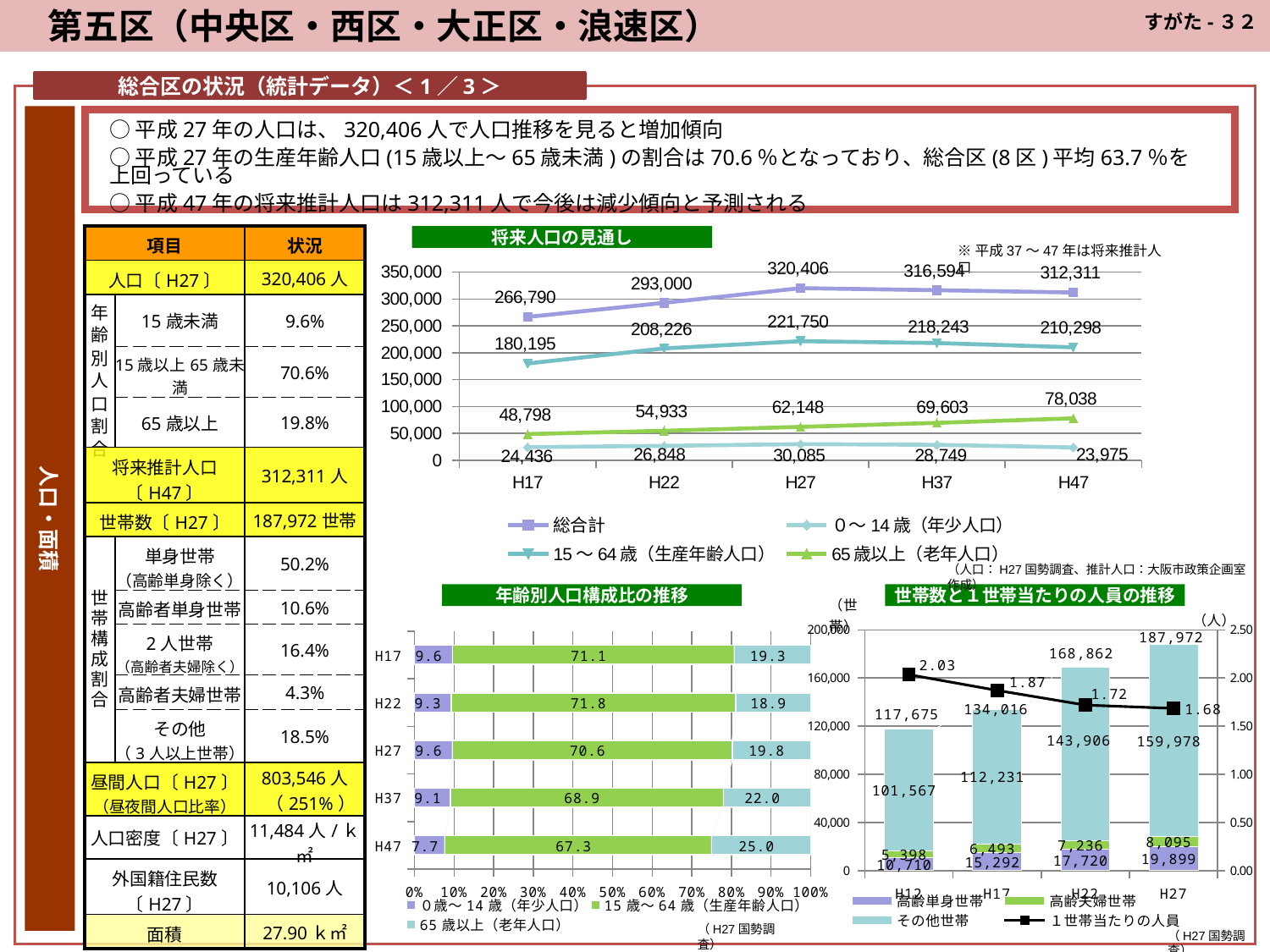
In the 将来人口の見通し chart, does the 65歳以上（老年人口） series rise or fall from H17 to H47? rise In the 年齢別人口構成比の推移 chart, which year has the lowest value for 0歳～14歳（年少人口）? H47 In the 世帯数と１世帯当たりの人員の推移 chart, what is the value for 高齢単身世帯 in H27? 19,899 What kind of chart is 年齢別人口構成比の推移? bar chart In the 将来人口の見通し chart, what is the value for 65歳以上（老年人口） in H47? 78,038 In the 将来人口の見通し chart, what is the difference between the 総合計 values for H27 and H47? 8,095 How many series does the legend of the 将来人口の見通し chart list? 4 In the 世帯数と１世帯当たりの人員の推移 chart, how many years are shown on the x axis? 4 In the 将来人口の見通し chart, what is the 総合計 value for H27? 320,406 In the 世帯数と１世帯当たりの人員の推移 chart, what is the 1世帯当たりの人員 value for H12? 2.03 In the 将来人口の見通し chart, which year has the highest 総合計 value? H27 In the 年齢別人口構成比の推移 chart, what is the value for 15歳～64歳（生産年齢人口） in H47? 67.3